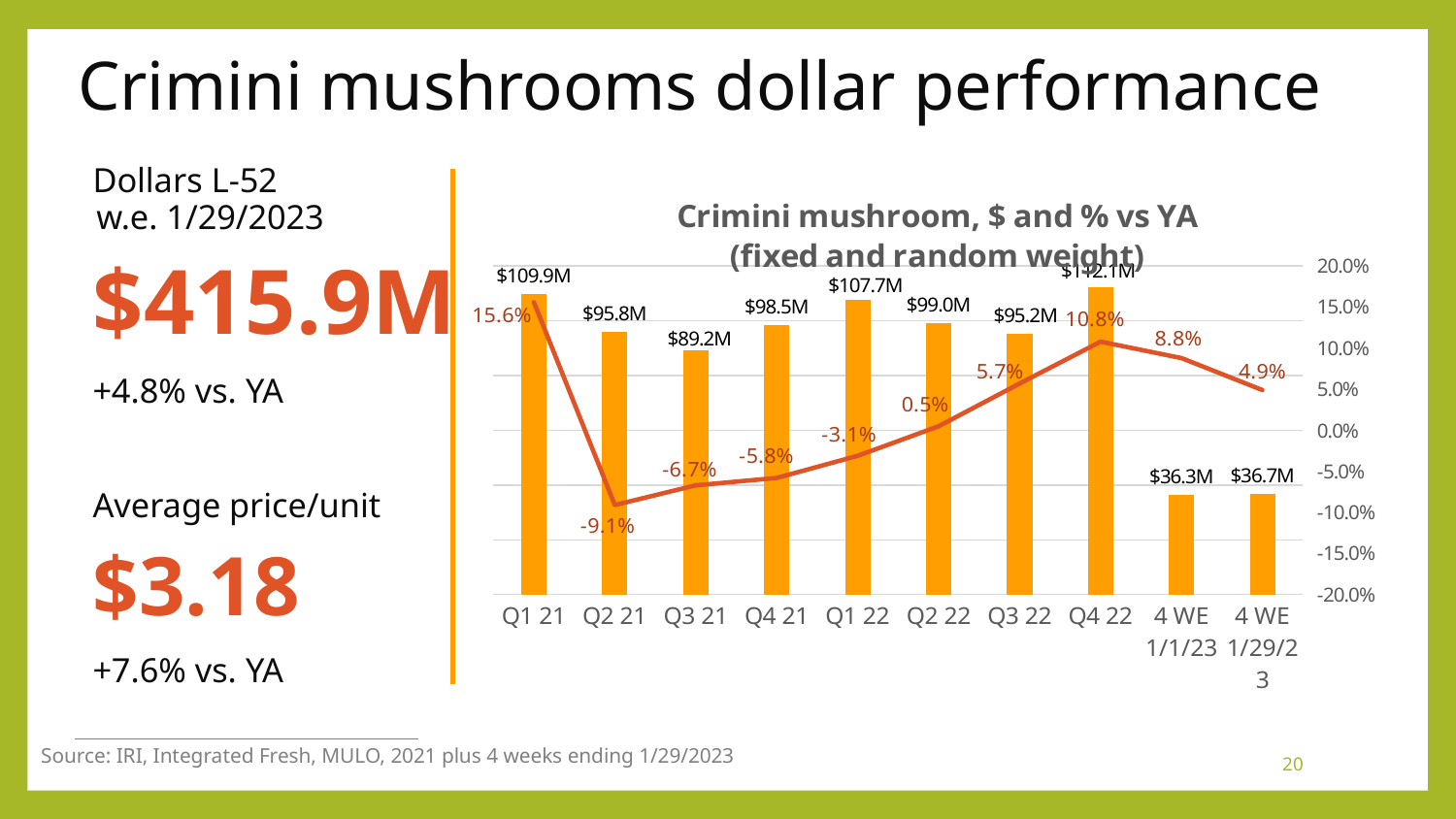
What is the % vs YA value shown for Q2 21? -9.1% What is the dollar value shown for Q3 21? $89.2M How many periods are shown on the x axis of the chart? 10 What is the dollar value shown for Q1 21? $109.9M Which is larger, the dollar value for Q4 21 or for Q3 21? Q4 21 Does the % vs YA line rise or fall from Q2 21 to Q4 22? Rise What is the title of the chart? Crimini mushroom, $ and % vs YA (fixed and random weight) What is the dollar value shown for the 4 WE 1/1/23 period? $36.3M What is the % vs YA value shown for the 4 WE 1/29/23 period? 4.9% What is the difference in dollars between Q1 22 and Q2 22? $8.7M Which period has the lowest % vs YA value on the line? Q2 21 Which period has the highest % vs YA value on the line? Q1 21